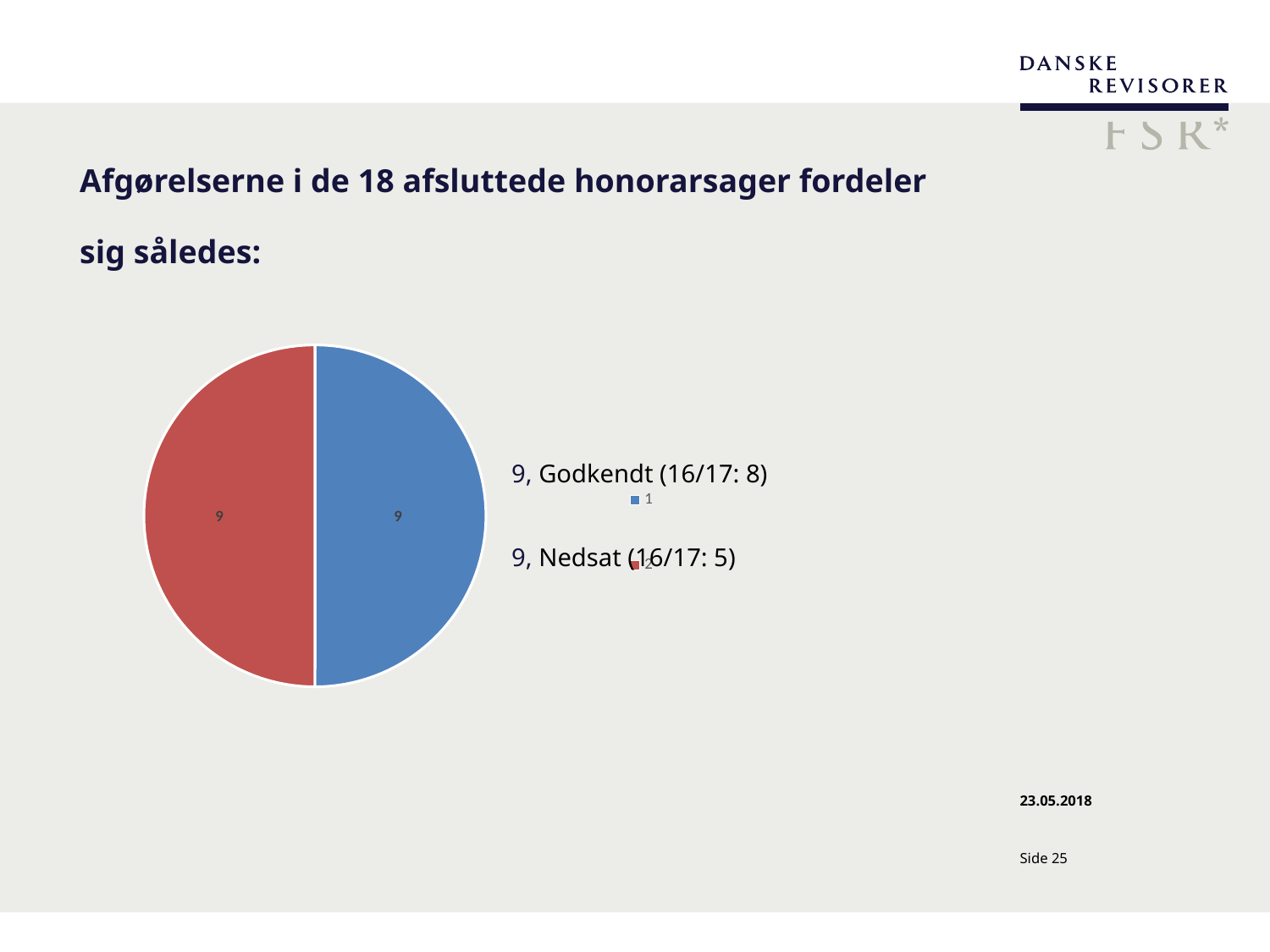
What share of the pie does the red slice represent? 50% What value is printed on the blue slice of the pie chart? 9 What kind of chart is shown on the slide? pie chart What is the difference between the values of the blue and red slices? 0 What is the total of the two values shown on the pie chart? 18 What colour is the slice labelled '1' in the legend? blue How many slices does the pie chart have? 2 According to the text next to the chart, how many cases were 'Nedsat'? 9 What value is printed on the red slice of the pie chart? 9 According to the text next to the chart, how many cases were 'Godkendt'? 9 What share of the pie does the blue slice represent? 50% How many entries does the chart legend list? 2